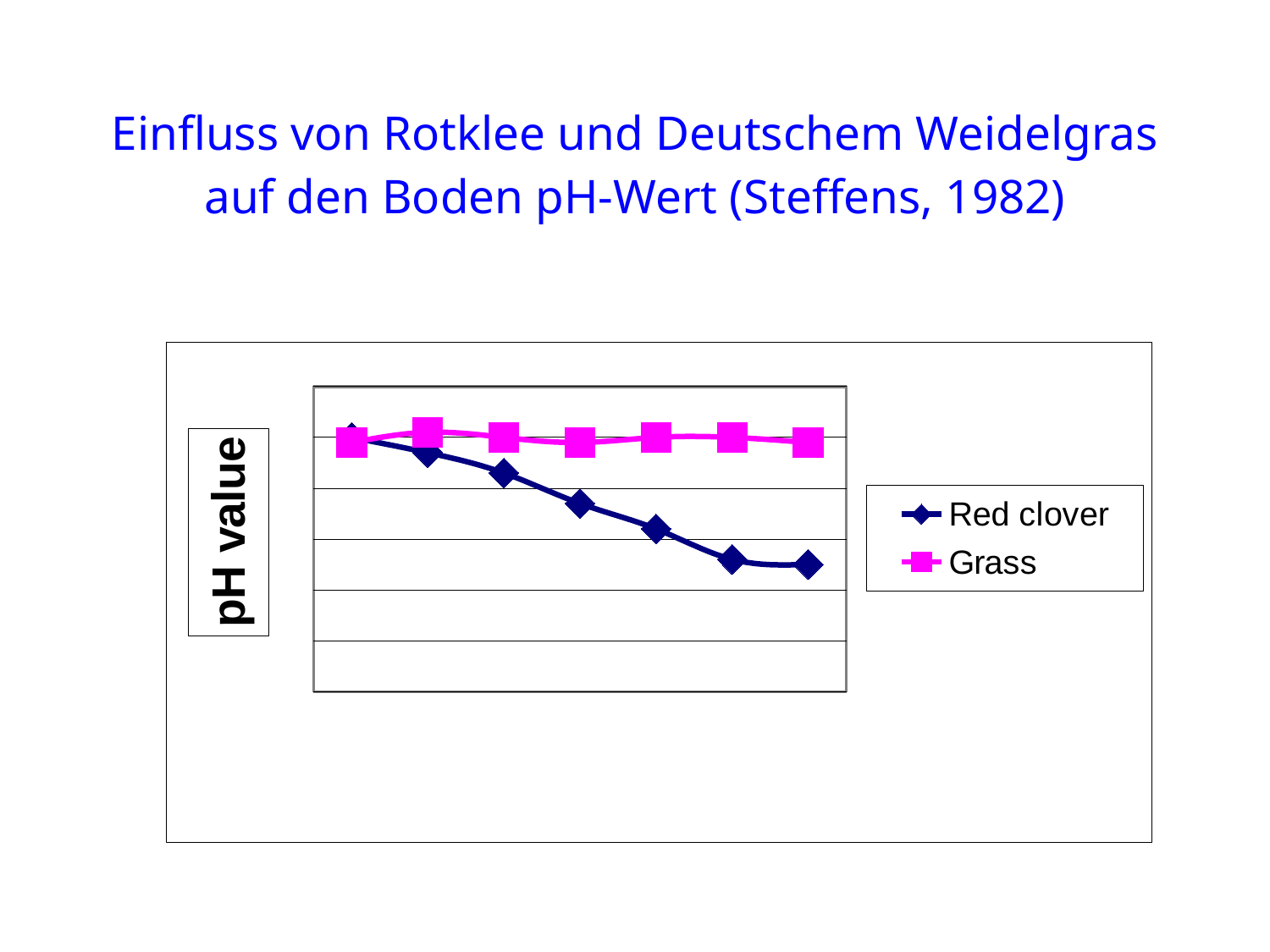
How many data points are plotted for the Red clover series? 7 At the last point on the x axis, which series has the higher pH value, Red clover or Grass? Grass Which two series are listed in the legend? Red clover and Grass What is the label on the vertical axis of the chart? pH value Does the Grass line show a clear rise, a clear fall, or stay roughly flat along the x axis? roughly flat Does the Red clover line rise or fall along the x axis? fall How many data points are plotted for the Grass series? 7 At the last point on the x axis, which series has the lower pH value, Red clover or Grass? Red clover How many series does the legend list? 2 Which series is drawn with square markers? Grass What kind of chart is shown on the slide? line chart Which series ends at the lowest pH value on the chart? Red clover